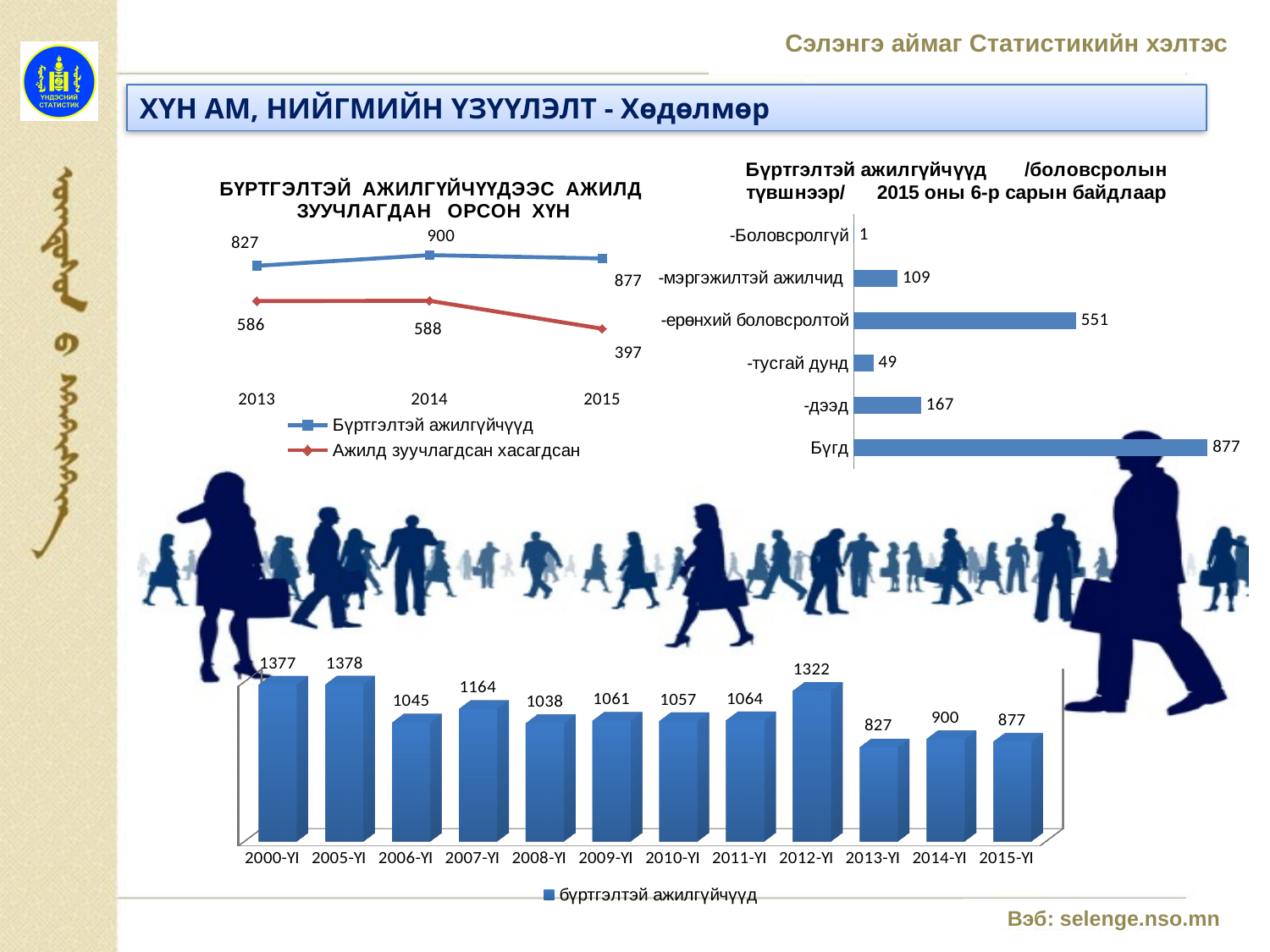
In the bottom bar chart, which year has the lowest value? 2013-YI In the bottom bar chart, what is the value for 2012-YI? 1322 In the top-right bar chart, which category other than Бүгд has the lowest value? -Боловсролгүй In the top-left line chart, what is the value for Бүртгэлтэй ажилгүйчүүд in 2014? 900 In the top-left line chart, what is the difference between the two series in 2013? 241 How many series does the legend of the top-left line chart list? 2 What kind of chart is the bottom chart on the slide? Bar chart In the top-right bar chart, what is the value for -ерөнхий боловсролтой? 551 How many categories are shown in the top-right bar chart? 6 In the top-right bar chart, which is larger, -дээд or -мэргэжилтэй ажилчид? -дээд In the bottom bar chart, what is the difference between 2005-YI and 2006-YI? 333 In the top-left line chart, what is the value for Ажилд зуучлагдсан хасагдсан in 2015? 397